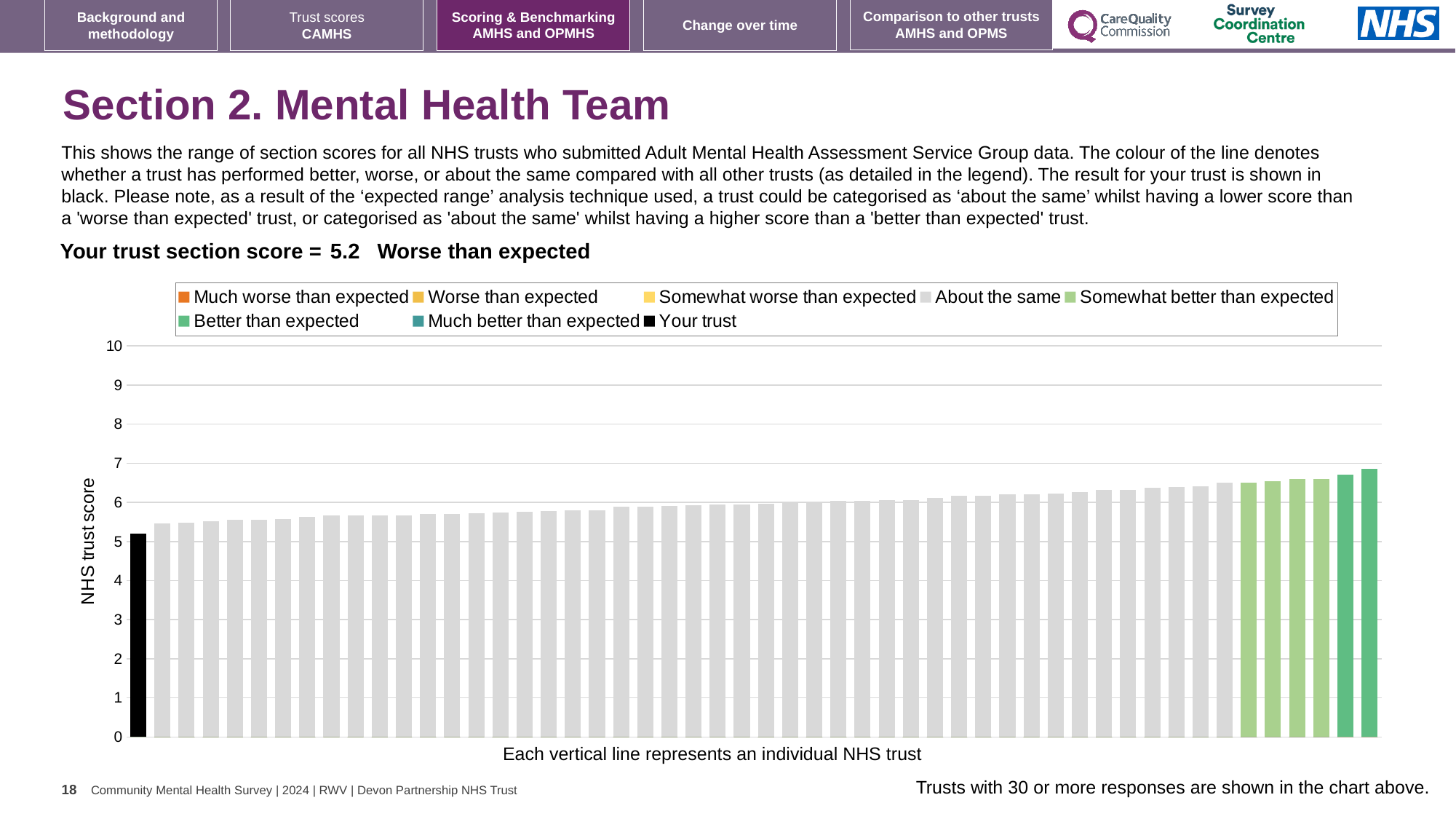
Which bar in the chart is the lowest? Your trust (the black bar) Is the value of the black 'Your trust' bar greater or less than 6? less What is the label on the vertical axis of the chart? NHS trust score Do the bar values rise or fall from left to right along the x axis? rise Is the value of the rightmost bar greater or less than 7? less What is the section score for your trust shown on the slide? 5.2 What kind of chart is shown on the slide? bar chart Is the value of the rightmost bar greater or less than 6? greater How many entries does the chart legend list? 8 What colour is the bar representing your trust? black Is the black 'Your trust' bar larger or smaller than the rightmost bar? smaller Which category does the slide assign to your trust's section score? Worse than expected